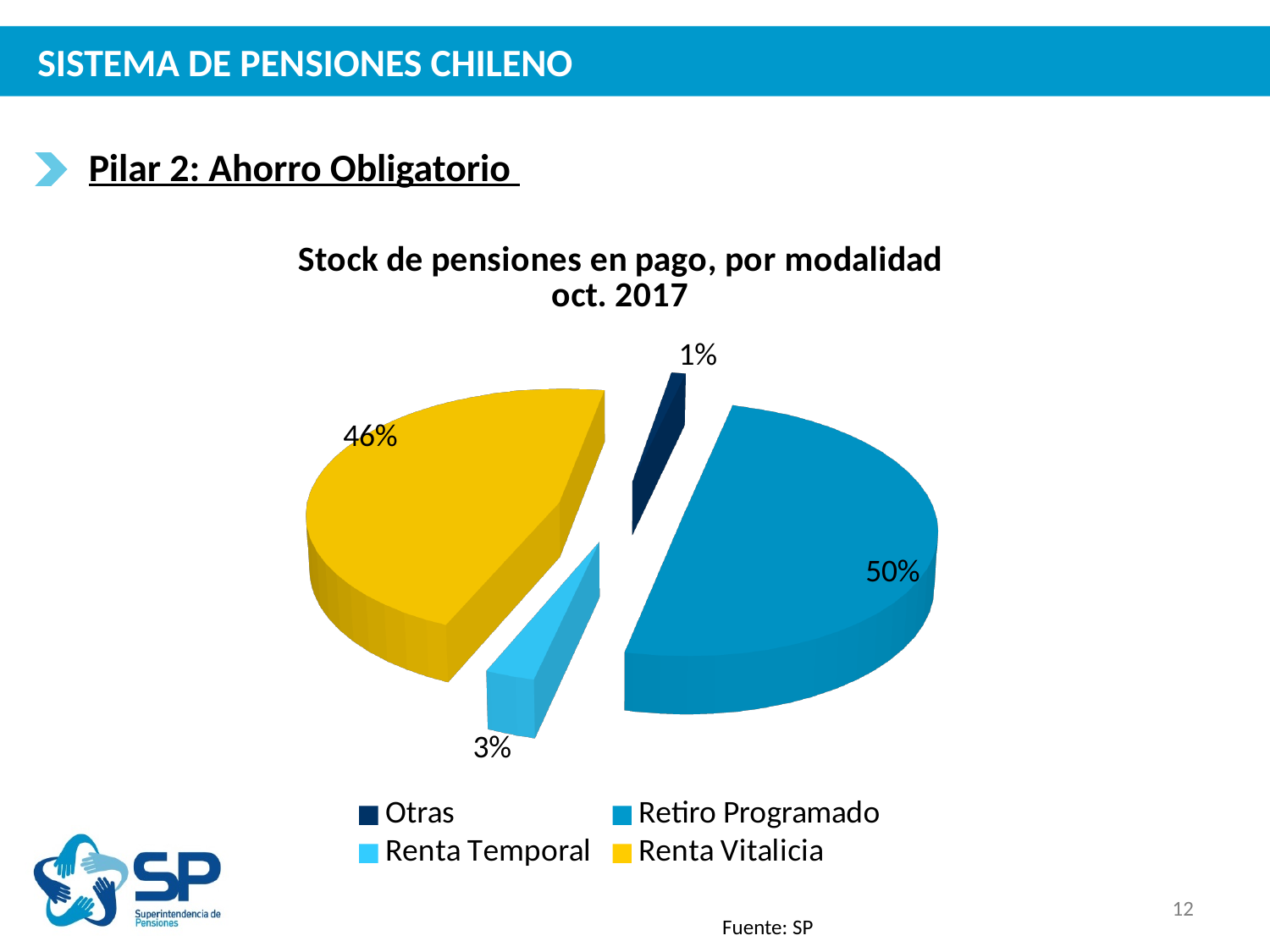
Which category has the smallest slice of the pie? Otras What kind of chart is shown on the slide? pie chart Which category has the largest slice of the pie? Retiro Programado What share of the pie does Renta Vitalicia represent? 46% Which colour represents Renta Vitalicia in the legend? yellow How many categories does the pie chart show? 4 What share of the pie does Retiro Programado represent? 50% Which is larger, the share for Renta Temporal or the share for Otras? Renta Temporal What is the difference in percentage points between Retiro Programado and Renta Vitalicia? 4 What share of the pie does Otras represent? 1% What is the title of the chart? Stock de pensiones en pago, por modalidad oct. 2017